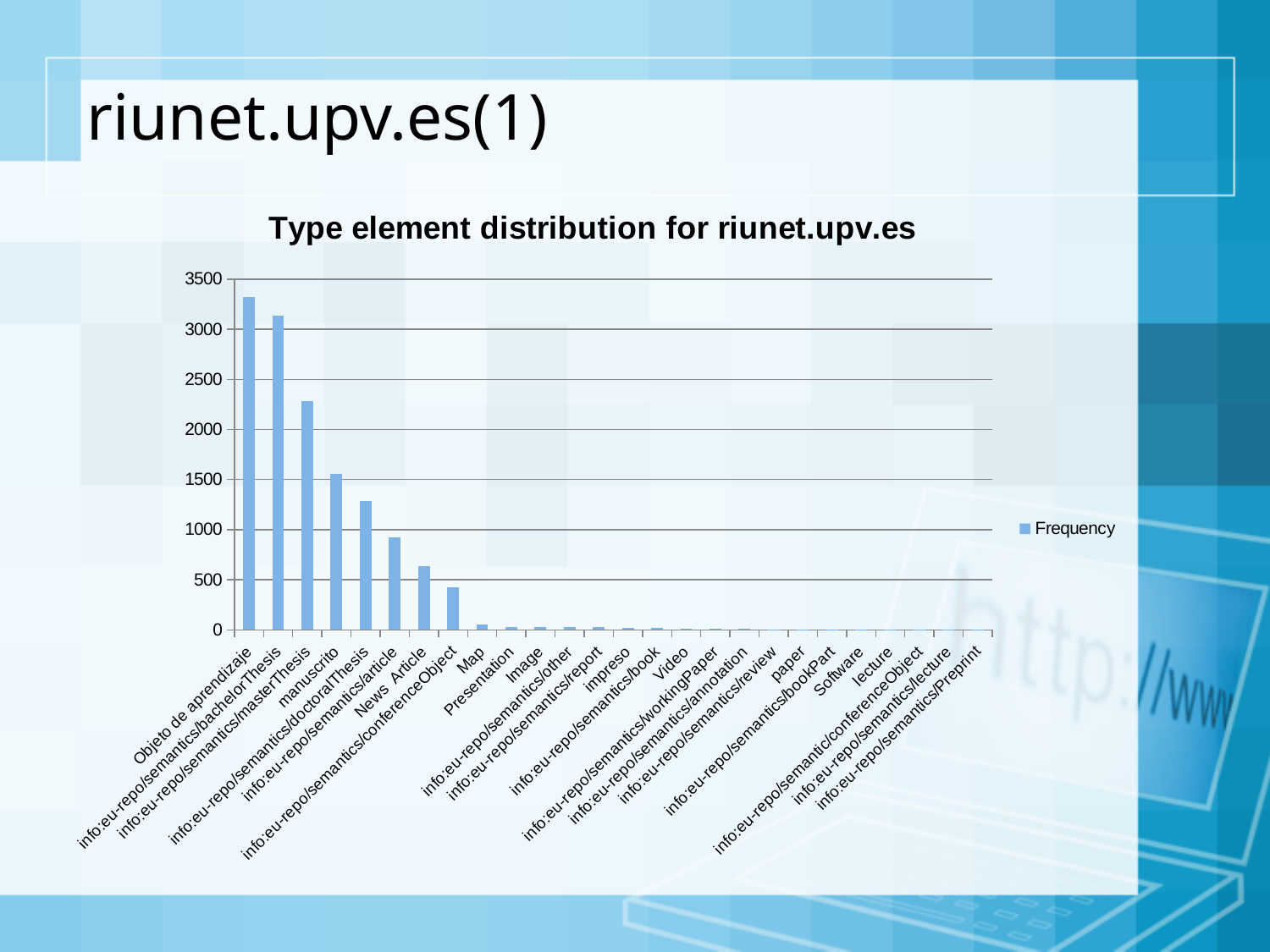
Which category has the highest frequency? Objeto de aprendizaje Is the value for info:eu-repo/semantics/masterThesis greater or less than 2000? greater Is the value for info:eu-repo/semantics/article greater or less than 1000? less Is the value for info:eu-repo/semantics/conferenceObject greater or less than 500? less What is the title of the chart? Type element distribution for riunet.upv.es Do the frequencies generally rise or fall moving from left to right along the x axis? fall Which has a larger frequency, info:eu-repo/semantics/masterThesis or manuscrito? info:eu-repo/semantics/masterThesis What is the name of the series shown in the legend? Frequency How many series does the legend list? 1 What kind of chart is shown on the slide? Bar chart How many categories are plotted on the x axis? 26